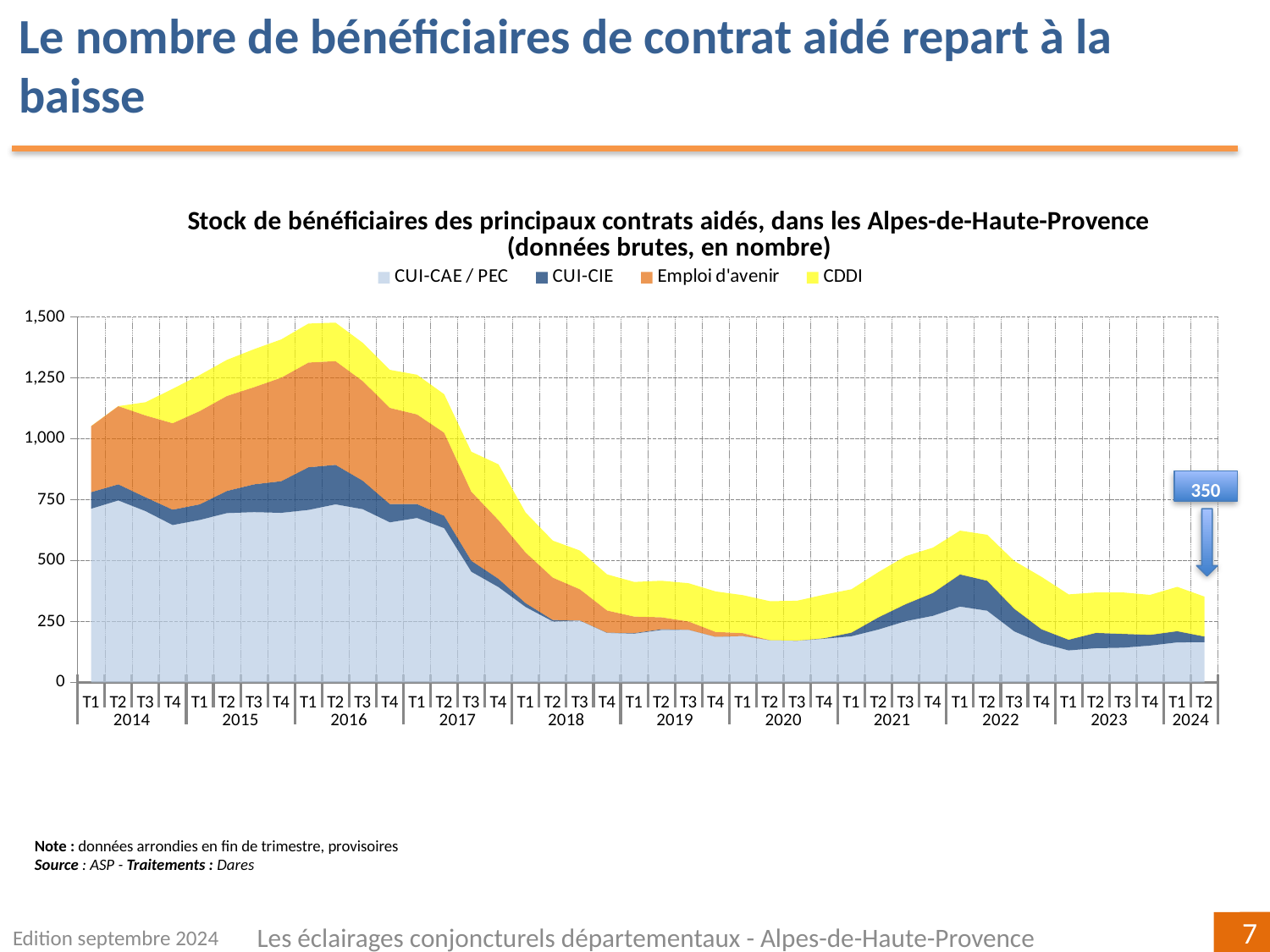
Which is larger, the total stock of beneficiaries in T1 2014 or in T1 2024? T1 2014 Is the total stock of beneficiaries in T1 2014 greater or less than 1,000? greater In which year does the total stock of beneficiaries reach its peak? 2016 Which series is plotted in yellow? CDDI Does the total stock of beneficiaries rise or fall between T2 2016 and T3 2020? fall What kind of chart is shown on the slide? stacked area chart What is the total stock of beneficiaries shown by the data label for T2 2024? 350 Is the total stock of beneficiaries in T1 2022 greater or less than 500? greater Is the total stock of beneficiaries in T1 2016 greater or less than 1,250? greater How many series does the legend list? 4 How many years are shown on the x axis? 11